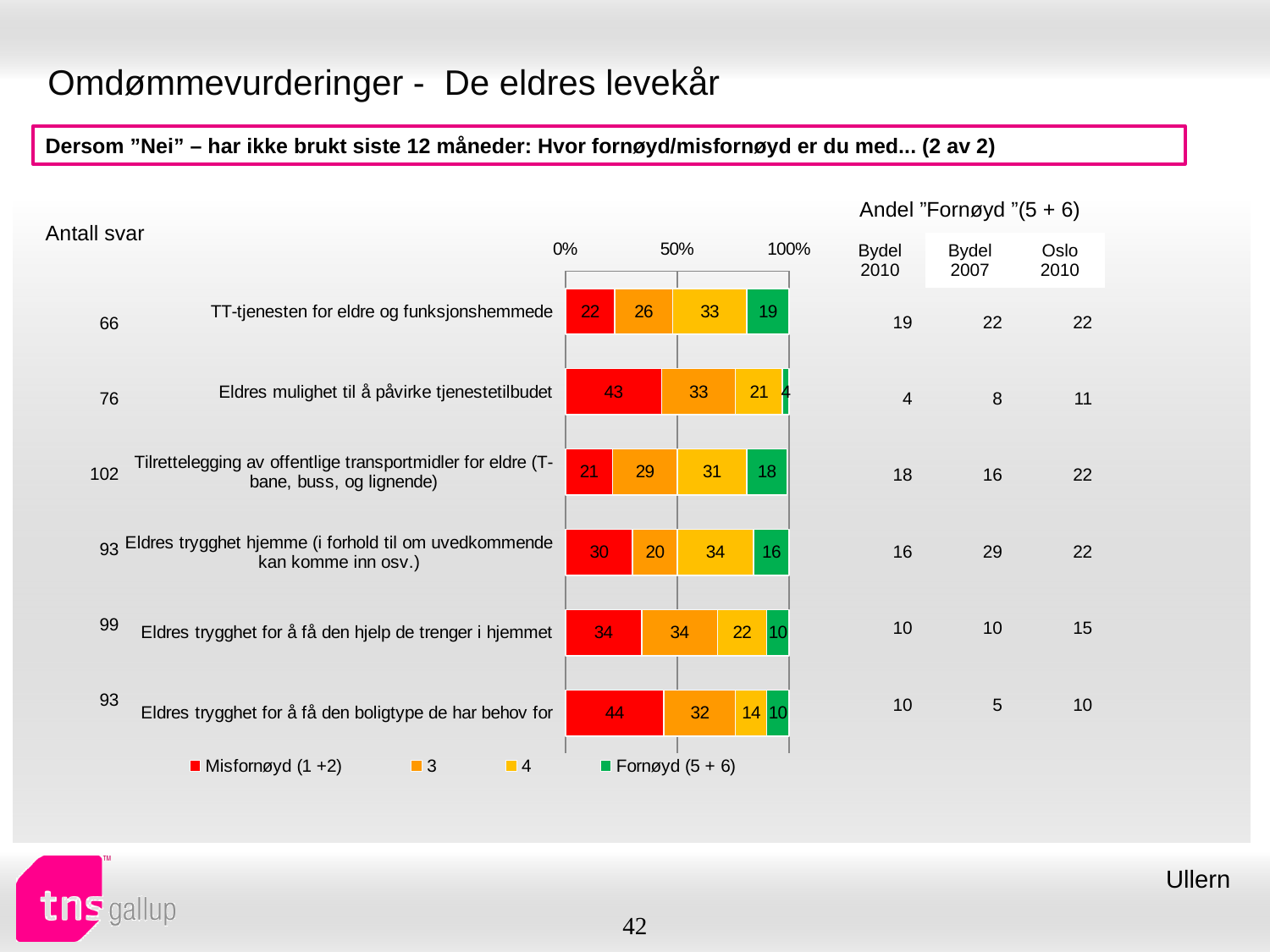
What colour represents the Fornøyd (5 + 6) series in the legend? Green How many categories are shown in the chart? 6 What is the Fornøyd (5 + 6) value for "Eldres mulighet til å påvirke tjenestetilbudet"? 4 What is the total of the stacked bar for "Eldres trygghet for å få den hjelp de trenger i hjemmet"? 100 How many series does the legend list? 4 Which is larger: the Fornøyd (5 + 6) value for "TT-tjenesten for eldre og funksjonshemmede" or for "Tilrettelegging av offentlige transportmidler for eldre (T-bane, buss, og lignende)"? TT-tjenesten for eldre og funksjonshemmede What is the Misfornøyd (1 +2) value for "TT-tjenesten for eldre og funksjonshemmede"? 22 Which category has the highest Misfornøyd (1 +2) value? Eldres trygghet for å få den boligtype de har behov for What is the value of series "4" for "Eldres trygghet hjemme (i forhold til om uvedkommende kan komme inn osv.)"? 34 What is the difference between the Misfornøyd (1 +2) values for "Eldres trygghet for å få den boligtype de har behov for" and "TT-tjenesten for eldre og funksjonshemmede"? 22 What kind of chart is shown on the slide? Stacked bar chart Which category has the lowest Fornøyd (5 + 6) value? Eldres mulighet til å påvirke tjenestetilbudet